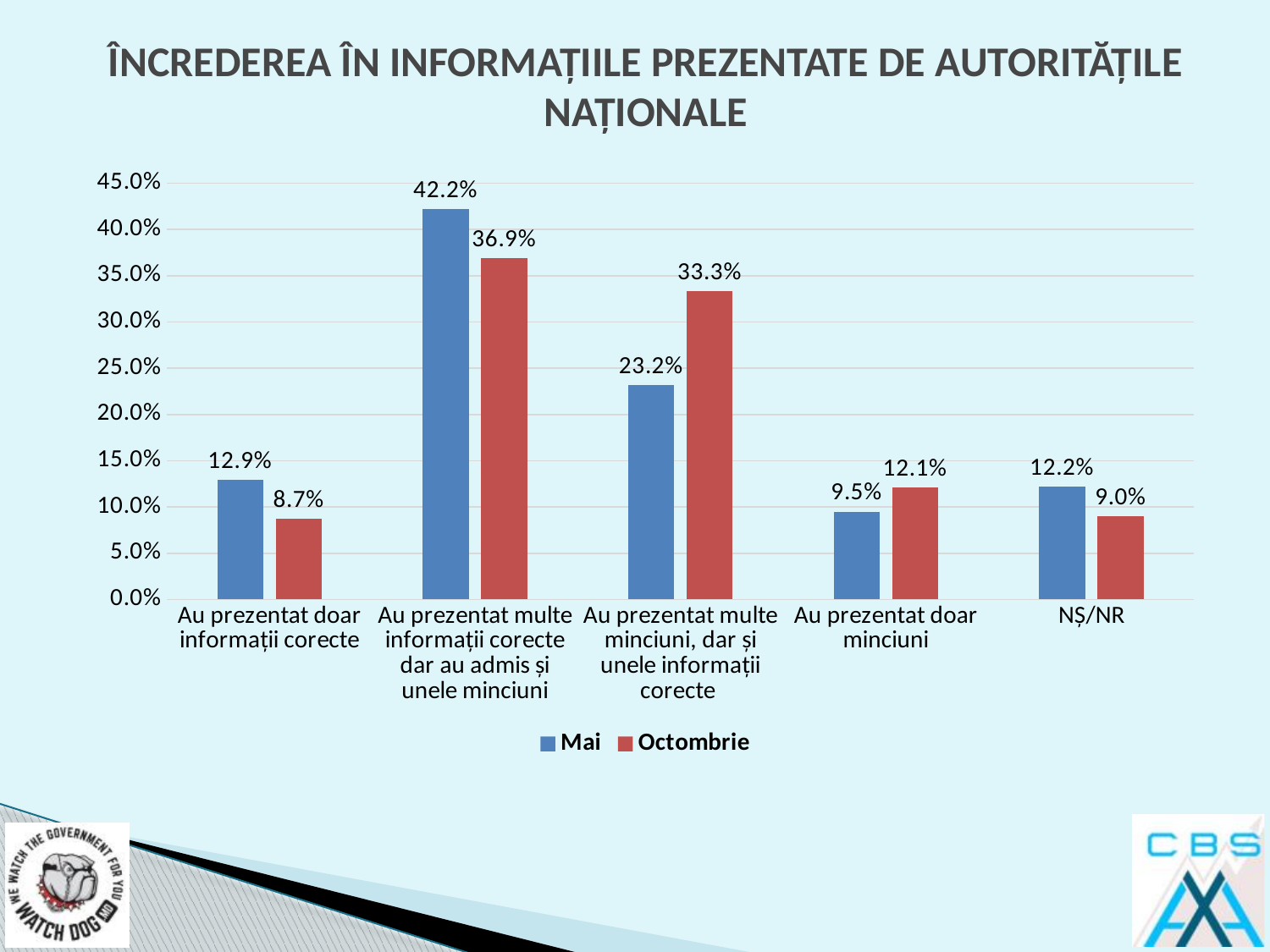
What is the difference between the "Mai" and "Octombrie" values for "Au prezentat multe minciuni, dar și unele informații corecte"? 10.1% Which category has the highest value for "Mai"? Au prezentat multe informații corecte dar au admis și unele minciuni Which colour represents the "Octombrie" series? red Is the "Mai" value for "Au prezentat multe informații corecte dar au admis și unele minciuni" greater or less than 40.0%? greater Which category has the lowest value for "Octombrie"? Au prezentat doar informații corecte What kind of chart is shown on the slide? bar chart Which is larger for "Au prezentat doar minciuni": the "Mai" value or the "Octombrie" value? Octombrie What is the value for "Octombrie" in the category "Au prezentat multe minciuni, dar și unele informații corecte"? 33.3% How many series does the legend list? 2 What is the value for "Octombrie" in the category "NȘ/NR"? 9.0% How many categories are shown on the x axis? 5 What is the value for "Mai" in the category "Au prezentat doar informații corecte"? 12.9%